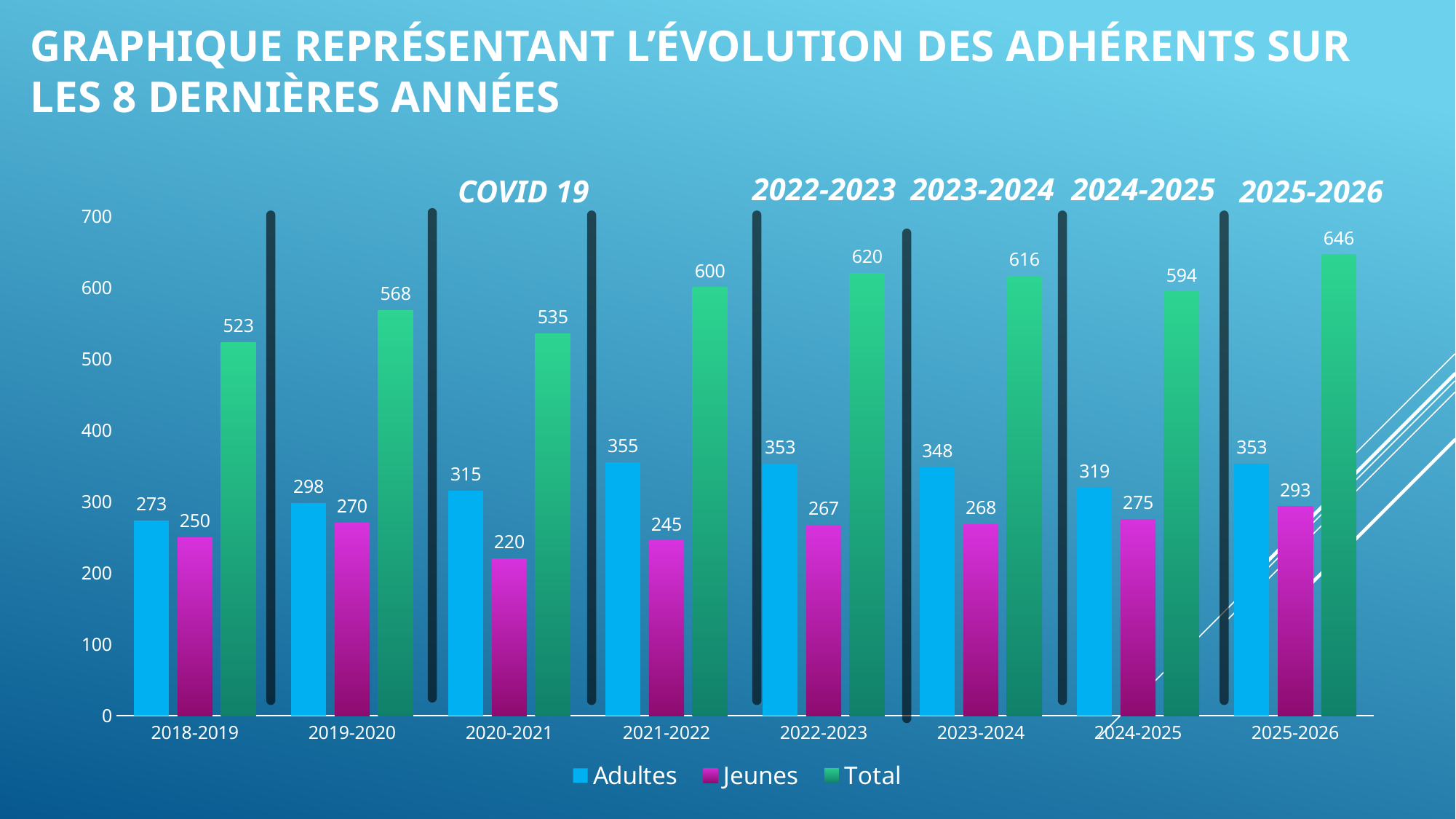
How many year categories are shown on the x axis? 8 Is the Total value for 2020-2021 greater or less than 500? greater What is the Total value for 2025-2026? 646 What is the value for Adultes in 2021-2022? 355 What is the difference between the Total values for 2025-2026 and 2018-2019? 123 What is the value for Jeunes in 2020-2021? 220 How many series does the legend list? 3 What kind of chart is shown on the slide? bar chart Which is larger, the Adultes value for 2022-2023 or the Adultes value for 2024-2025? 2022-2023 What are the three series listed in the legend? Adultes, Jeunes, Total Which year has the lowest Jeunes value? 2020-2021 Which year has the highest Total value? 2025-2026